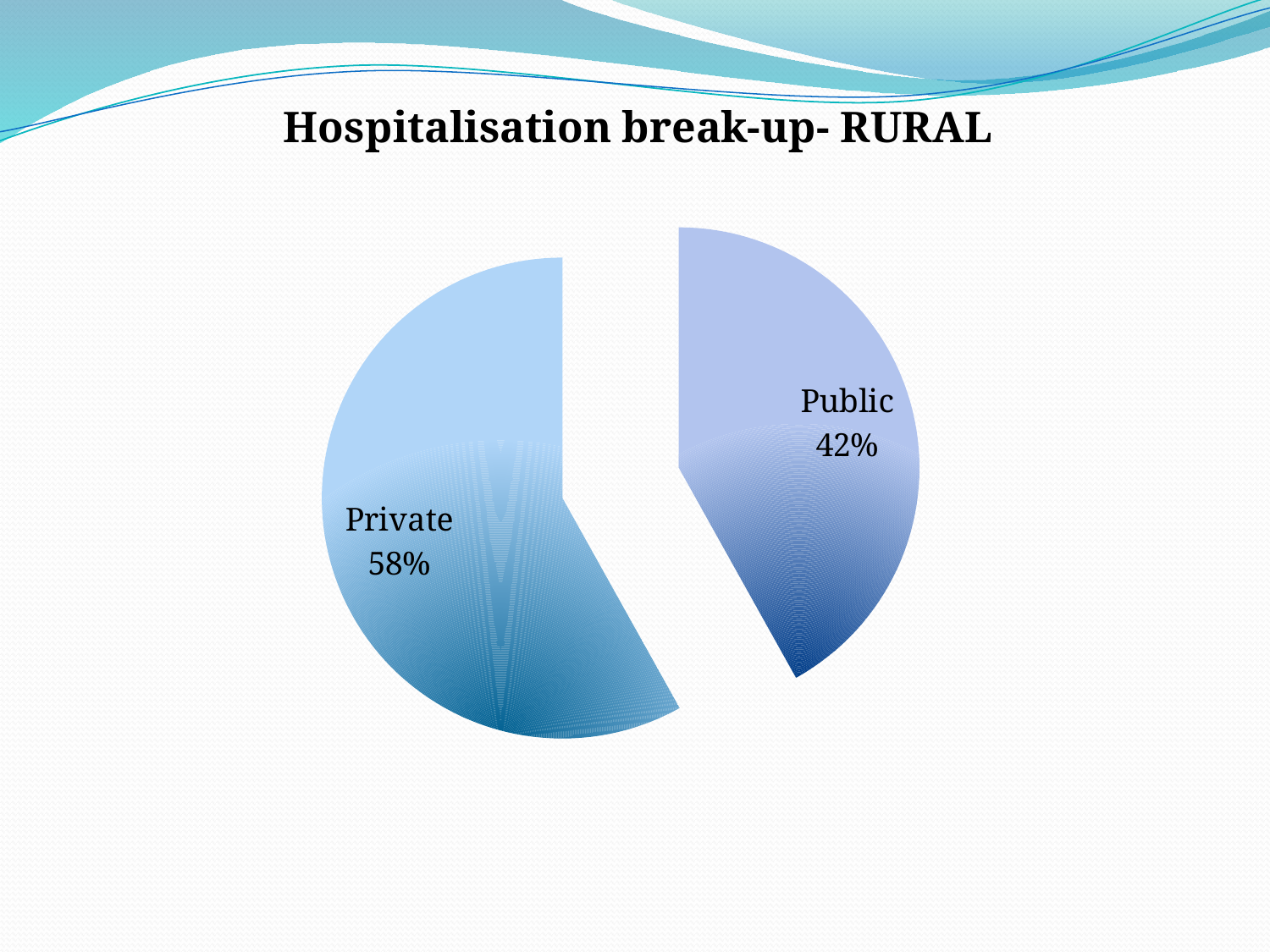
What is the value for Public? 42% Which category has the smallest share? Public What type of chart is shown on the slide? Pie chart What is the value for Private? 58% Which is larger, Private or Public? Private What share of the pie does Public represent? 42% Which category has the largest share? Private Is the value for Private greater or less than 50%? greater What is the difference between the Private and Public shares? 16% What is the title of the slide? Hospitalisation break-up- RURAL How many slices does the pie chart have? 2